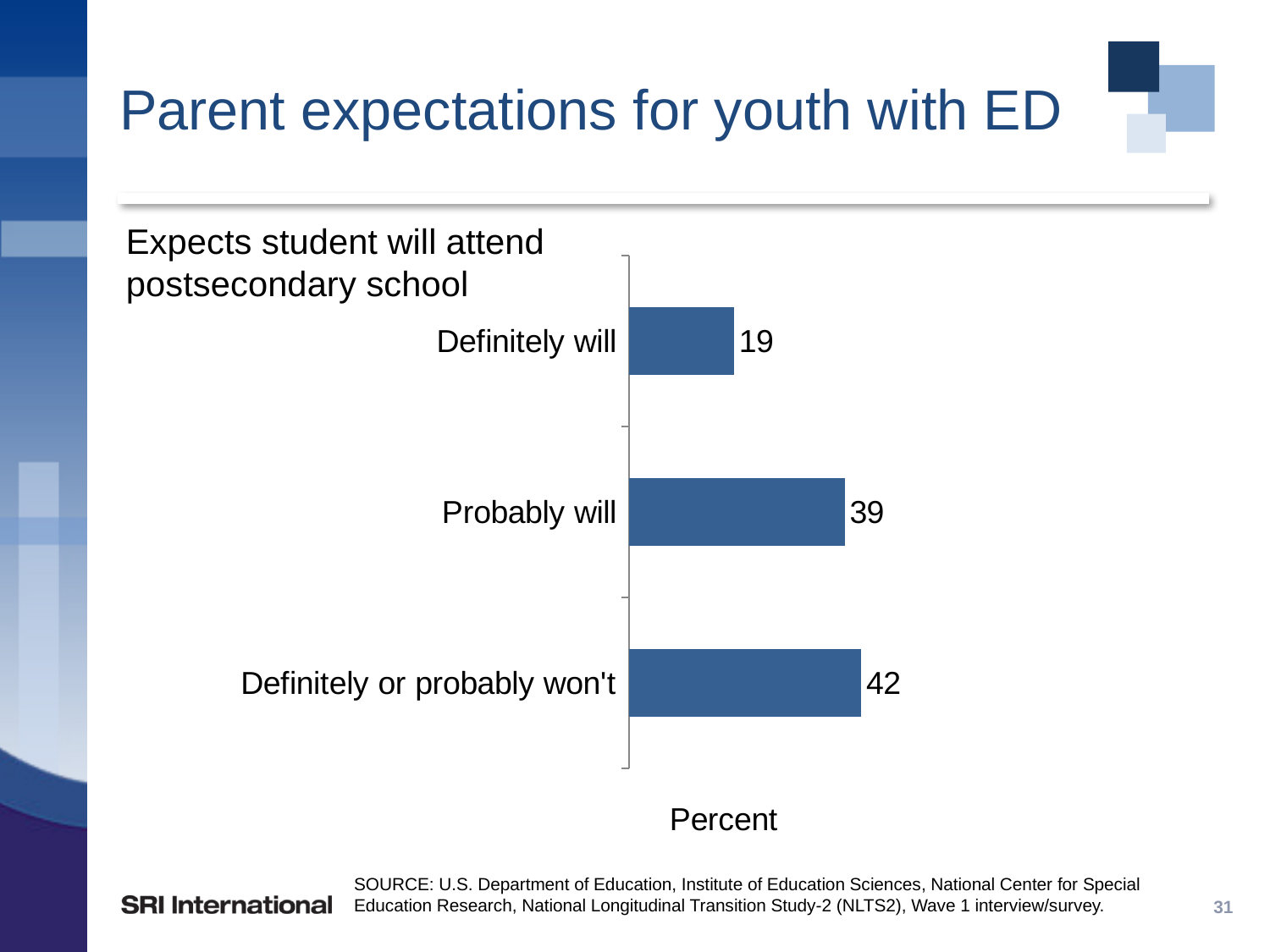
Which category has the lowest value? Definitely will Which category has the highest value? Definitely or probably won't Which is larger, the value for "Probably will" or the value for "Definitely will"? Probably will How many categories are shown in the chart? 3 What is the difference between the values for "Definitely or probably won't" and "Definitely will"? 23 What is the label on the horizontal axis of the chart? Percent What is the title of the slide? Parent expectations for youth with ED What kind of chart is shown on the slide? Bar chart What is the value for "Probably will"? 39 What is the difference between the values for "Probably will" and "Definitely will"? 20 What is the value for "Definitely will"? 19 What is the value for "Definitely or probably won't"? 42